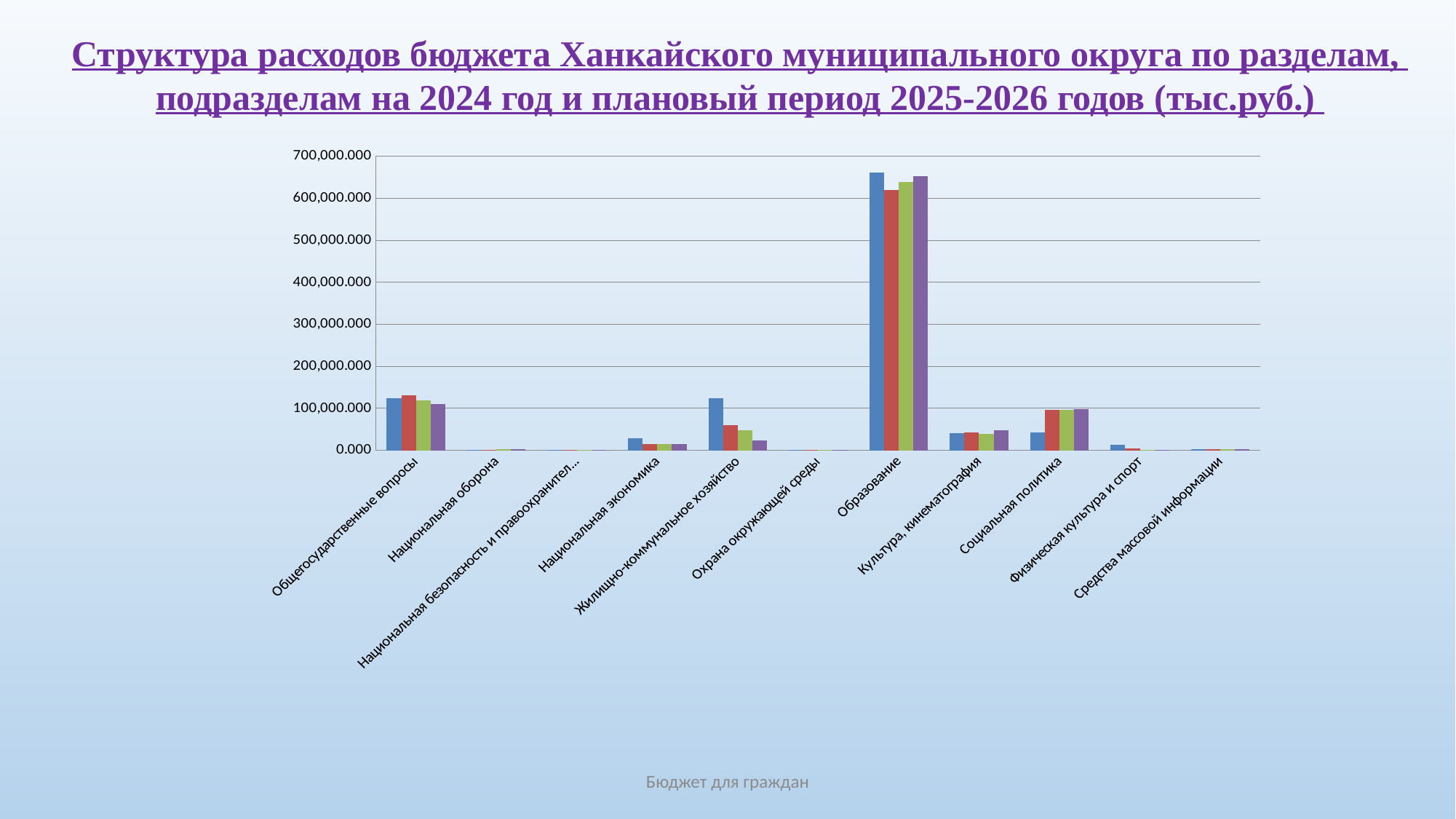
Which category has larger values, Образование or Социальная политика? Образование What is the title of the slide containing the chart? Структура расходов бюджета Ханкайского муниципального округа по разделам, подразделам на 2024 год и плановый период 2025-2026 годов (тыс.руб.) How many bars are plotted for each category in the chart? 4 Is the value of the first (blue) bar for Культура, кинематография greater or less than 100,000.000? less What is the highest value shown on the vertical axis of the chart? 700,000.000 Which category has a larger first (blue) bar, Общегосударственные вопросы or Национальная экономика? Общегосударственные вопросы Which category has the highest bars in the chart? Образование Is the value of the first (blue) bar for Жилищно-коммунальное хозяйство greater or less than 200,000.000? less What kind of chart is shown on the slide? bar chart Is the value of the first (blue) bar for Общегосударственные вопросы greater or less than 200,000.000? less How many expenditure categories are shown along the x axis of the chart? 11